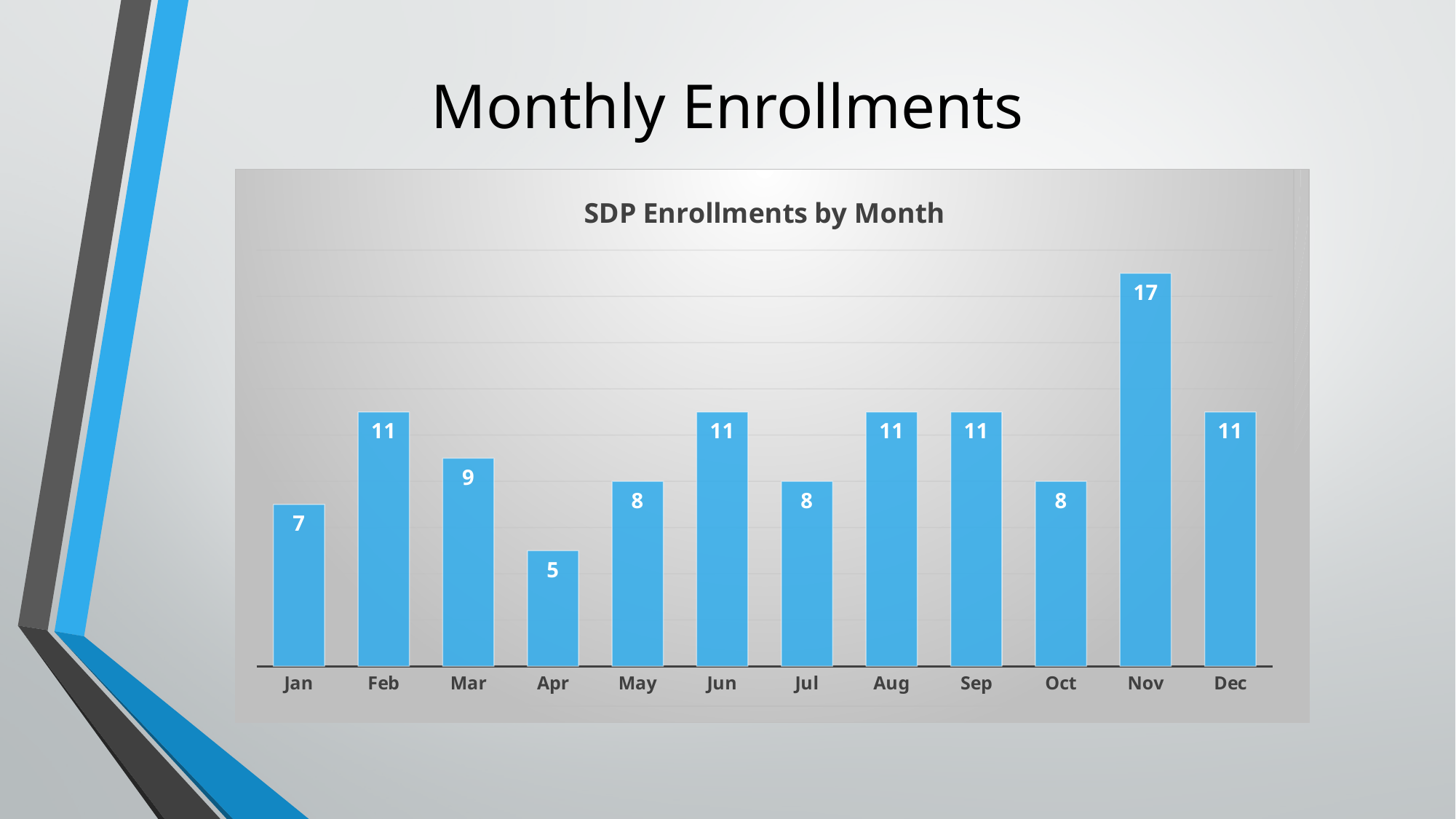
What is the difference between the values for Feb and Jan? 4 What kind of chart is shown? Bar chart Which month has the lowest value? Apr What is the value for Mar? 9 What is the title of the chart? SDP Enrollments by Month What is the value for Nov? 17 Which is larger, the value for Mar or the value for Oct? Mar What is the value for Apr? 5 How many months are shown on the x axis? 12 Which month has the highest value? Nov What is the value for Jul? 8 What is the difference between the values for Nov and Dec? 6